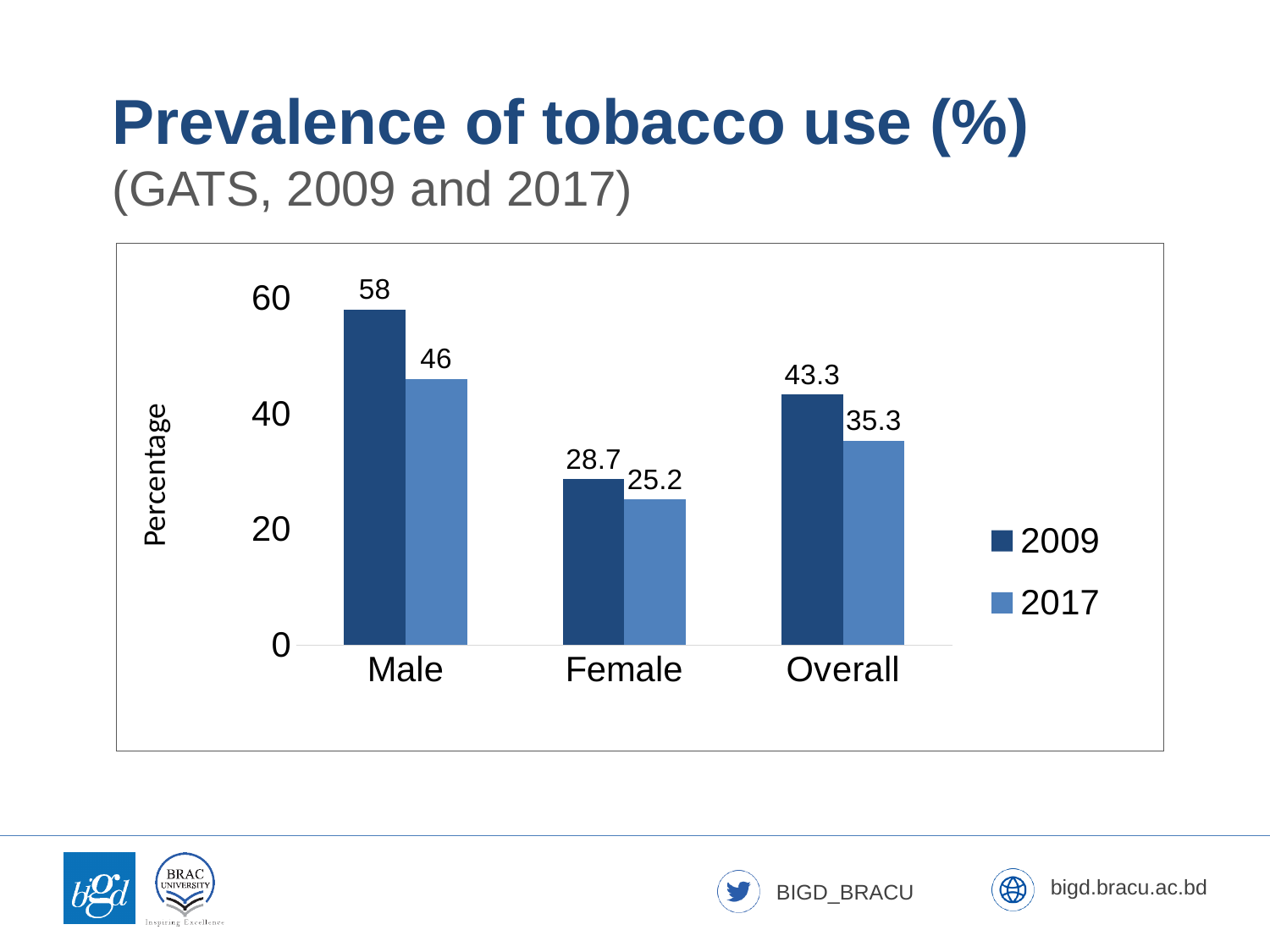
What kind of chart is shown on the slide? Bar chart How many series does the legend list? 2 What is the Overall value for 2017? 35.3 What is the difference between the Overall values for 2009 and 2017? 8 By how much did the Male value fall from 2009 to 2017? 12 Which category has the lowest value in the 2017 series? Female What was the prevalence of tobacco use among males in 2009? 58 How many categories are shown on the x axis? 3 Which is larger, the Female value in 2009 or the Female value in 2017? Female value in 2009 Which category has the highest value in the 2009 series? Male What was the prevalence of tobacco use among females in 2017? 25.2 Is the Overall value for 2009 greater or less than 40? greater